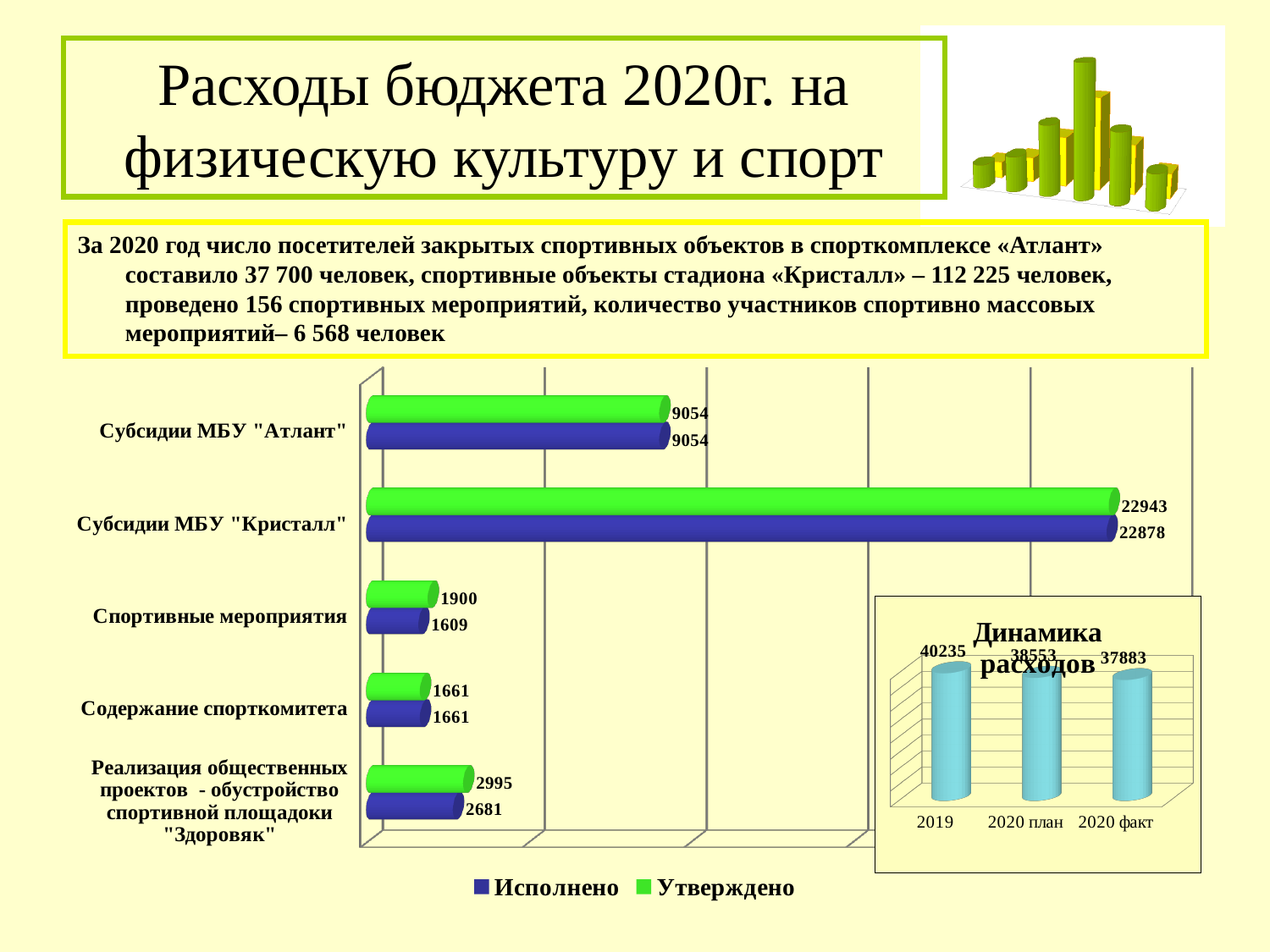
In the large bar chart on the left, what is the Исполнено value for Спортивные мероприятия? 1609 In the large bar chart on the left, what is the Исполнено value for Субсидии МБУ "Кристалл"? 22878 In the large bar chart on the left, how many series does the legend list? 2 In the large bar chart on the left, what is the Утверждено value for Реализация общественных проектов - обустройство спортивной площадоки "Здоровяк"? 2995 In the chart titled Динамика расходов, what is the value for 2020 факт? 37883 In the chart titled Динамика расходов, which category has the highest value? 2019 In the large bar chart on the left, what is the Утверждено value for Субсидии МБУ "Кристалл"? 22943 In the large bar chart on the left, which category has the lowest Утверждено value? Содержание спорткомитета In the large bar chart on the left, which category has the highest Исполнено value? Субсидии МБУ "Кристалл" In the large bar chart on the left, what is the difference between the Утверждено and Исполнено values for Спортивные мероприятия? 291 In the chart titled Динамика расходов, what is the difference between the 2020 план and 2020 факт values? 670 In the large bar chart on the left, how many categories are shown? 5